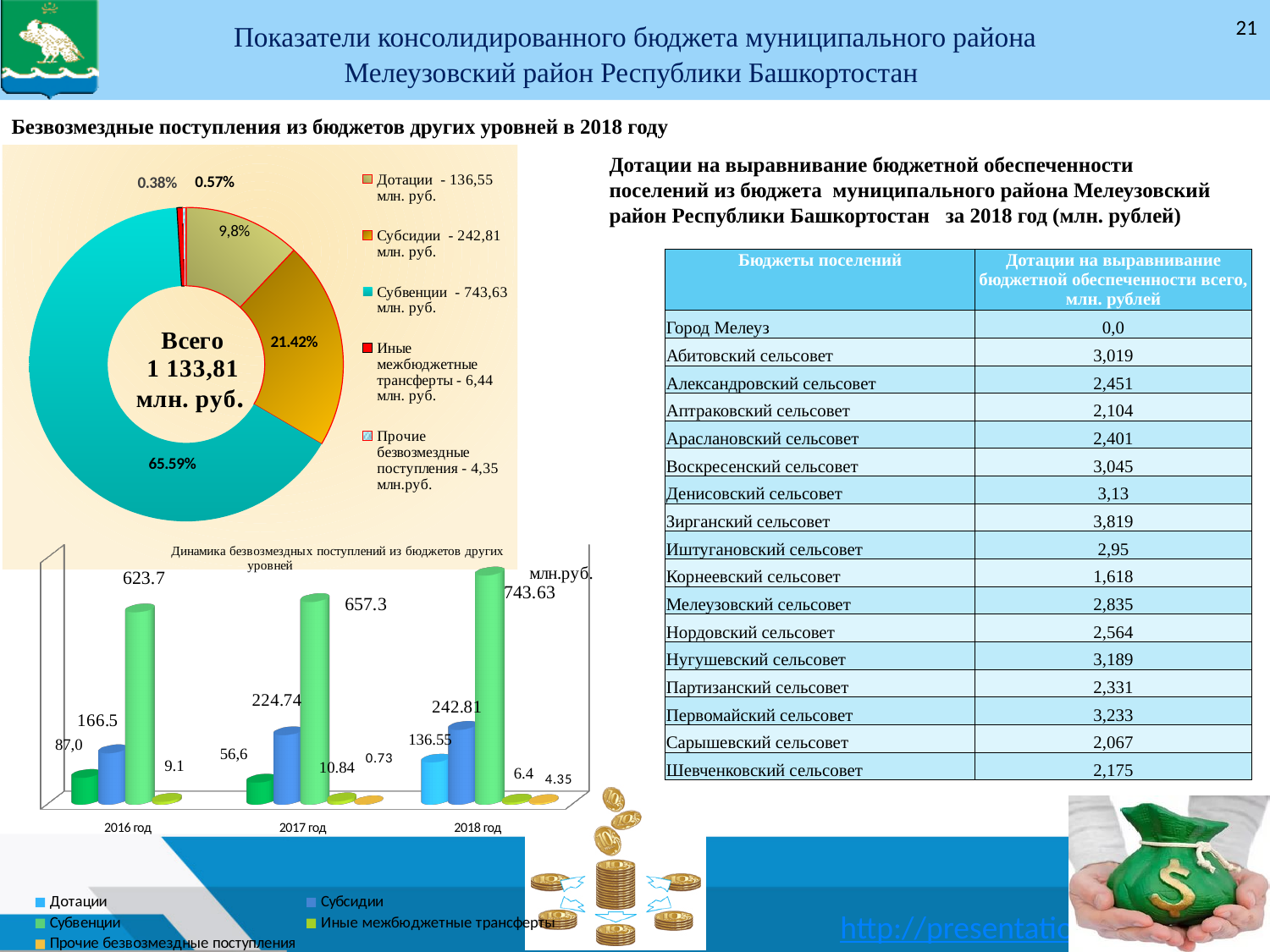
In the bar chart 'Динамика безвозмездных поступлений из бюджетов других уровней', do the values for Субвенции rise or fall from 2016 год to 2018 год? Rise In the donut chart on the left, what is the value for Субвенции? 743,63 млн. руб. In the bar chart 'Динамика безвозмездных поступлений из бюджетов других уровней', what is the difference between Субсидии in 2018 год and in 2017 год? 18.07 In the donut chart on the left, which category has the largest value? Субвенции How many categories does the donut chart on the left show? 5 In the donut chart on the left, what share of the total do Субвенции make up? 65.59% In the bar chart 'Динамика безвозмездных поступлений из бюджетов других уровней', what is the value for Субвенции in 2016 год? 623.7 What kind of chart is the chart at the top left of the slide? Pie (donut) chart In the bar chart 'Динамика безвозмездных поступлений из бюджетов других уровней', which year has the larger value for Дотации, 2016 год or 2017 год? 2016 год In the donut chart on the left, which category has the smallest value? Прочие безвозмездные поступления In the donut chart on the left, what is the total shown in the centre? 1 133,81 млн. руб. How many series does the legend of the bar chart 'Динамика безвозмездных поступлений из бюджетов других уровней' list? 5